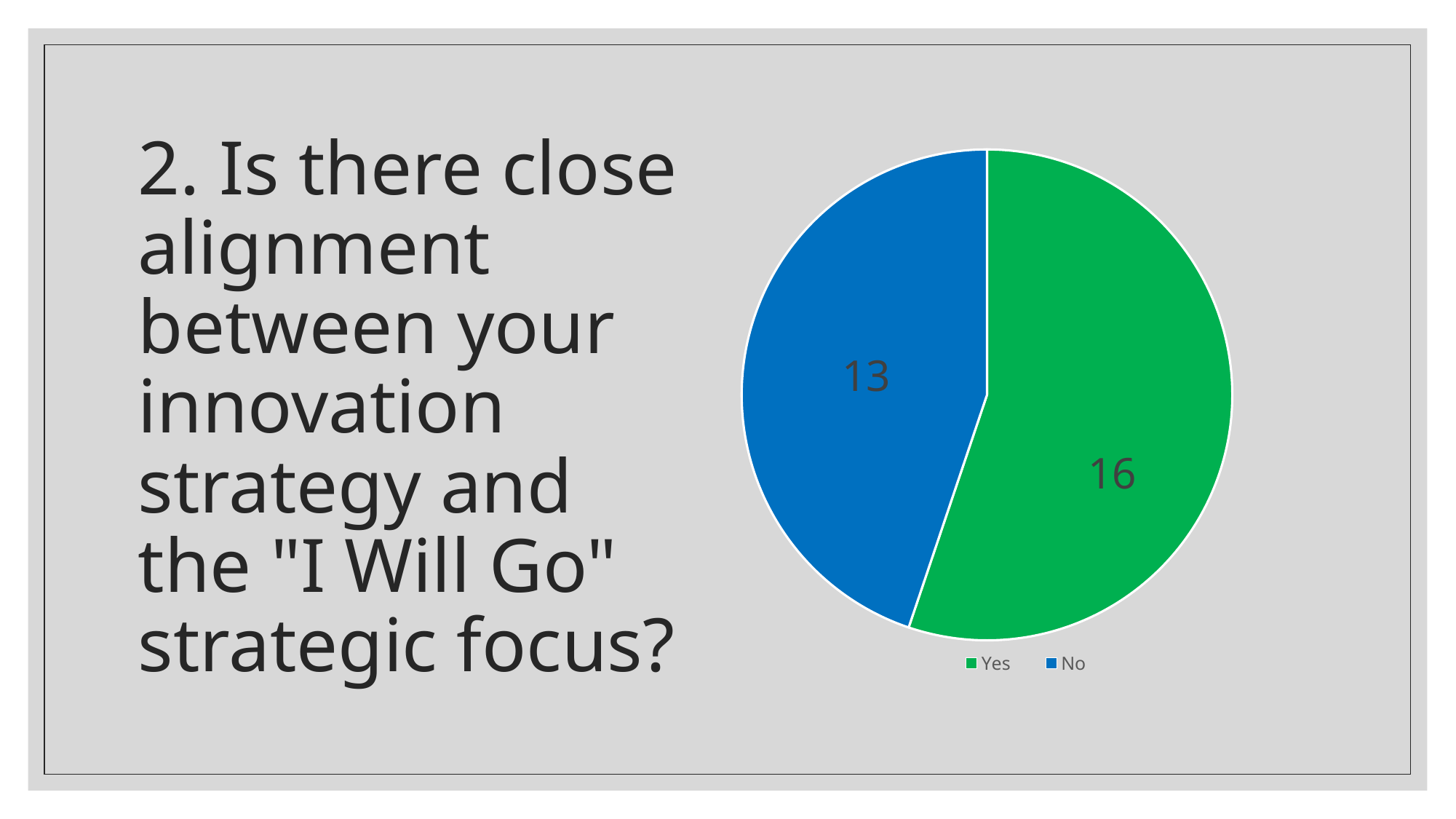
What is the difference between the Yes and No values? 3 What is the value for No? 13 What colour is the No slice? blue Which is larger, Yes or No? Yes What is the total of all slices in the pie chart? 29 What kind of chart is shown on the slide? pie chart How many slices does the pie chart have? 2 What is the value for Yes? 16 Which category has the largest slice? Yes How many entries does the legend list? 2 What colour is the Yes slice? green Which category has the smallest slice? No